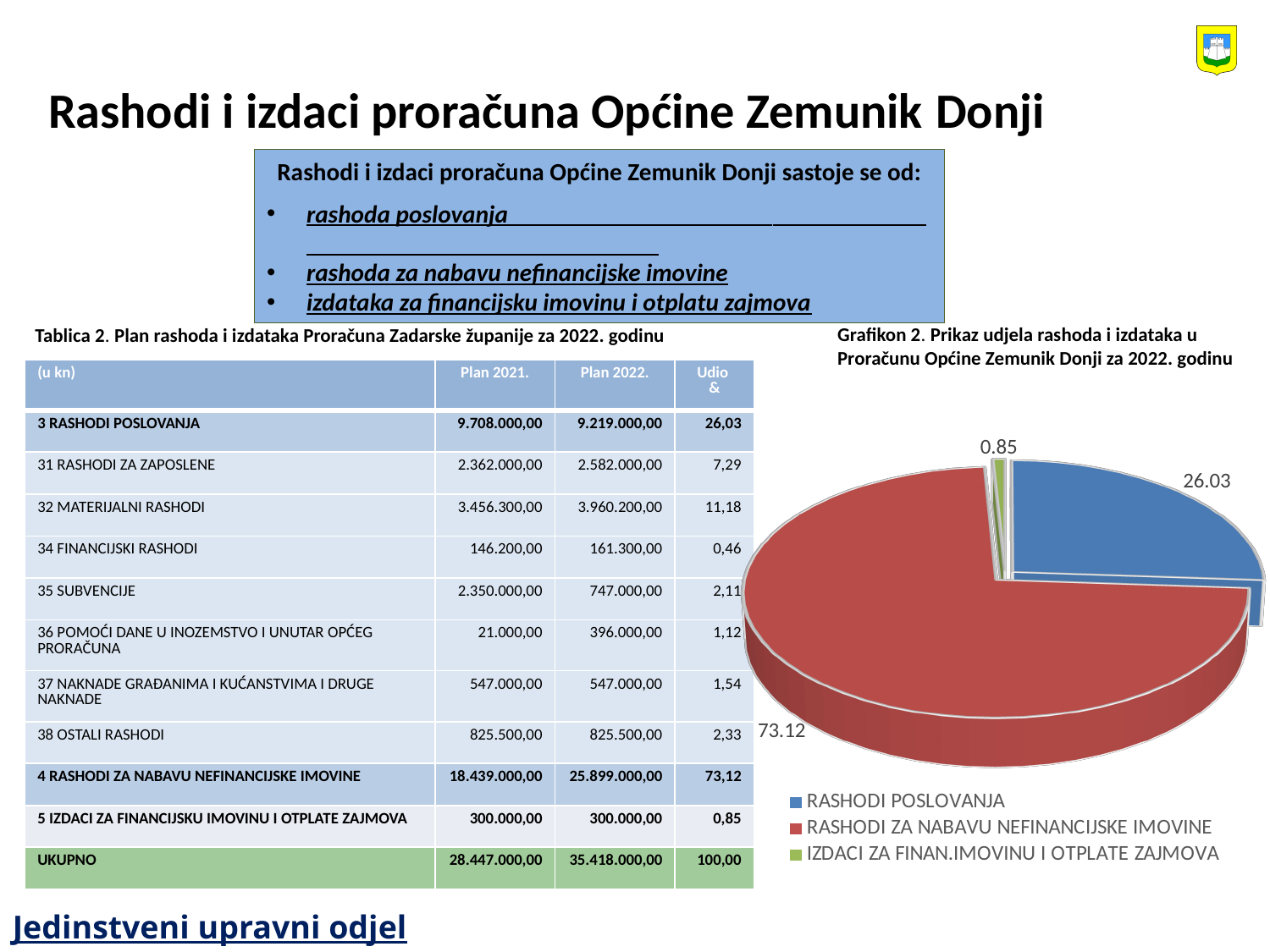
What is the value shown for IZDACI ZA FINAN.IMOVINU I OTPLATE ZAJMOVA in the pie chart? 0.85 What is the title of the chart (Grafikon 2) on the slide? Prikaz udjela rashoda i izdataka u Proračunu Općine Zemunik Donji za 2022. godinu How many entries does the legend of the pie chart list? 3 What is the value shown for RASHODI ZA NABAVU NEFINANCIJSKE IMOVINE in the pie chart? 73.12 Which category has the largest slice in the pie chart? RASHODI ZA NABAVU NEFINANCIJSKE IMOVINE What kind of chart is shown on the slide? pie chart What colour is the slice for RASHODI ZA NABAVU NEFINANCIJSKE IMOVINE in the pie chart? red Which category has the smallest slice in the pie chart? IZDACI ZA FINAN.IMOVINU I OTPLATE ZAJMOVA How many slices does the pie chart have? 3 What is the difference between the values for RASHODI ZA NABAVU NEFINANCIJSKE IMOVINE and RASHODI POSLOVANJA in the pie chart? 47.09 What is the value shown for RASHODI POSLOVANJA in the pie chart? 26.03 Which is larger in the pie chart: RASHODI POSLOVANJA or IZDACI ZA FINAN.IMOVINU I OTPLATE ZAJMOVA? RASHODI POSLOVANJA